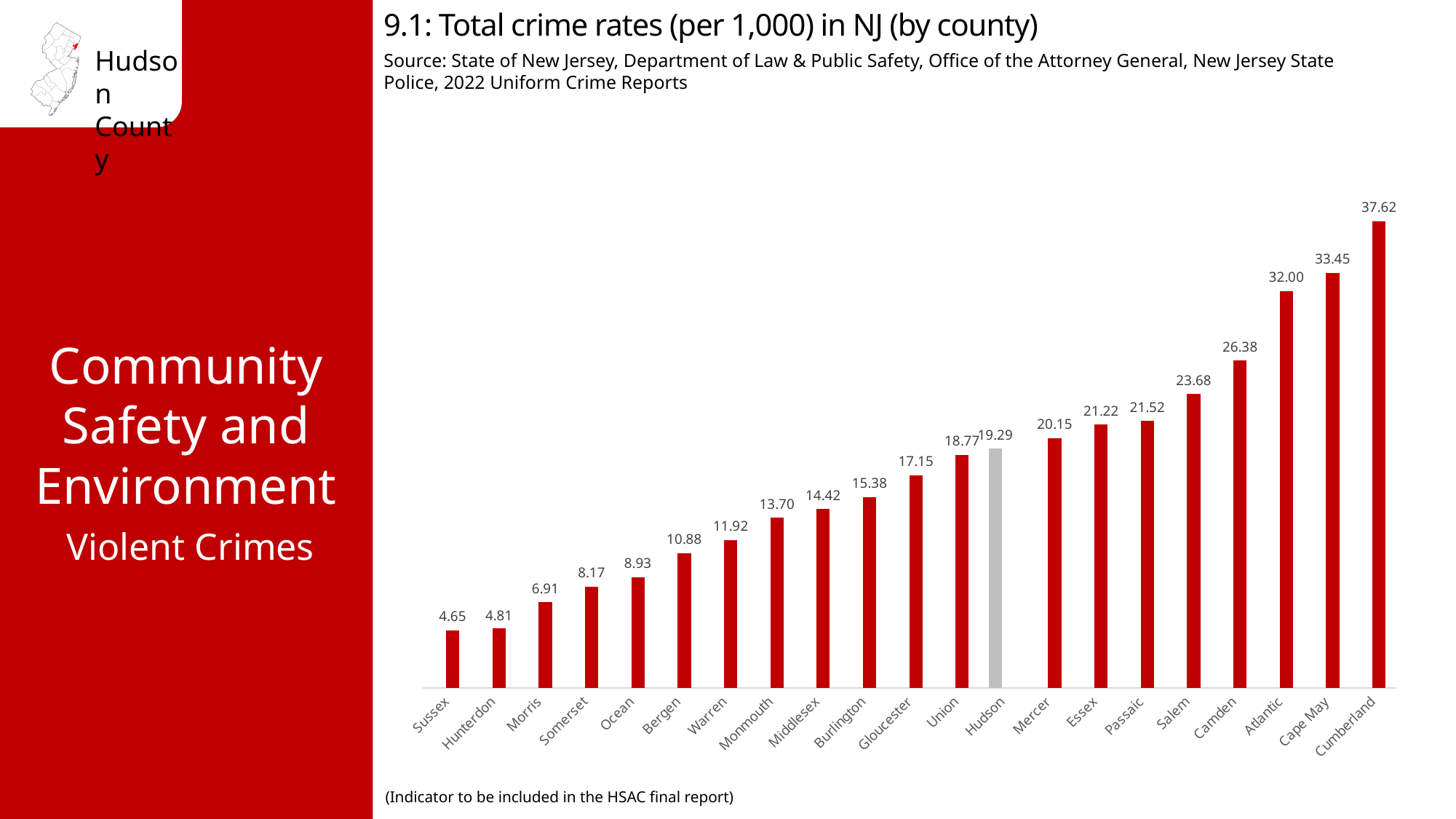
What is the difference between the total crime rates of Cumberland and Hudson? 18.33 Which county has the highest total crime rate? Cumberland Do the total crime rates rise or fall from left to right across the counties? Rise What is the total crime rate per 1,000 for Hudson County? 19.29 What is the difference between the total crime rates of Hudson and Sussex? 14.64 What kind of chart is shown on the slide? Bar chart How many counties are shown in the chart? 21 Which county has the lowest total crime rate? Sussex What is the total crime rate per 1,000 for Bergen County? 10.88 What is the total crime rate per 1,000 for Camden County? 26.38 Which county has a higher total crime rate, Morris or Ocean? Ocean Which county has a higher total crime rate, Atlantic or Cape May? Cape May